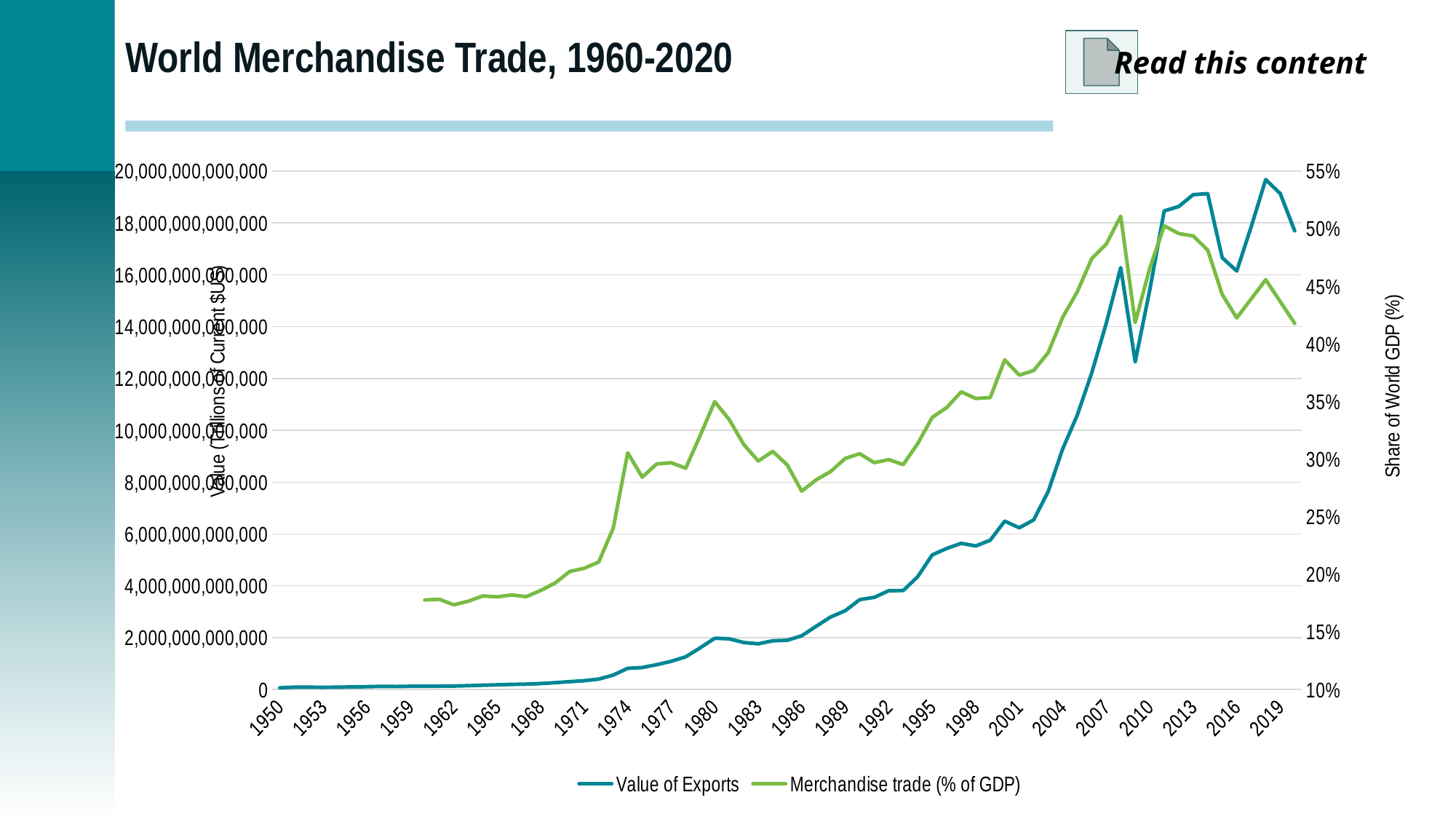
Is the Merchandise trade (% of GDP) value in 2020 greater or less than 45%? less Does the Merchandise trade (% of GDP) line rise or fall between 1960 and 1974? rise Does the Merchandise trade (% of GDP) line rise or fall between 1980 and 1986? fall Does the Value of Exports generally rise or fall between 1950 and 2007? rise Is the Value of Exports in 2009 greater or less than 14,000,000,000,000? less What kind of chart is shown on the slide? Line chart What are the two series named in the legend? Value of Exports; Merchandise trade (% of GDP) What is the title of the chart? World Merchandise Trade, 1960-2020 Is the Value of Exports in 1995 greater or less than 4,000,000,000,000? greater How many series does the legend list? 2